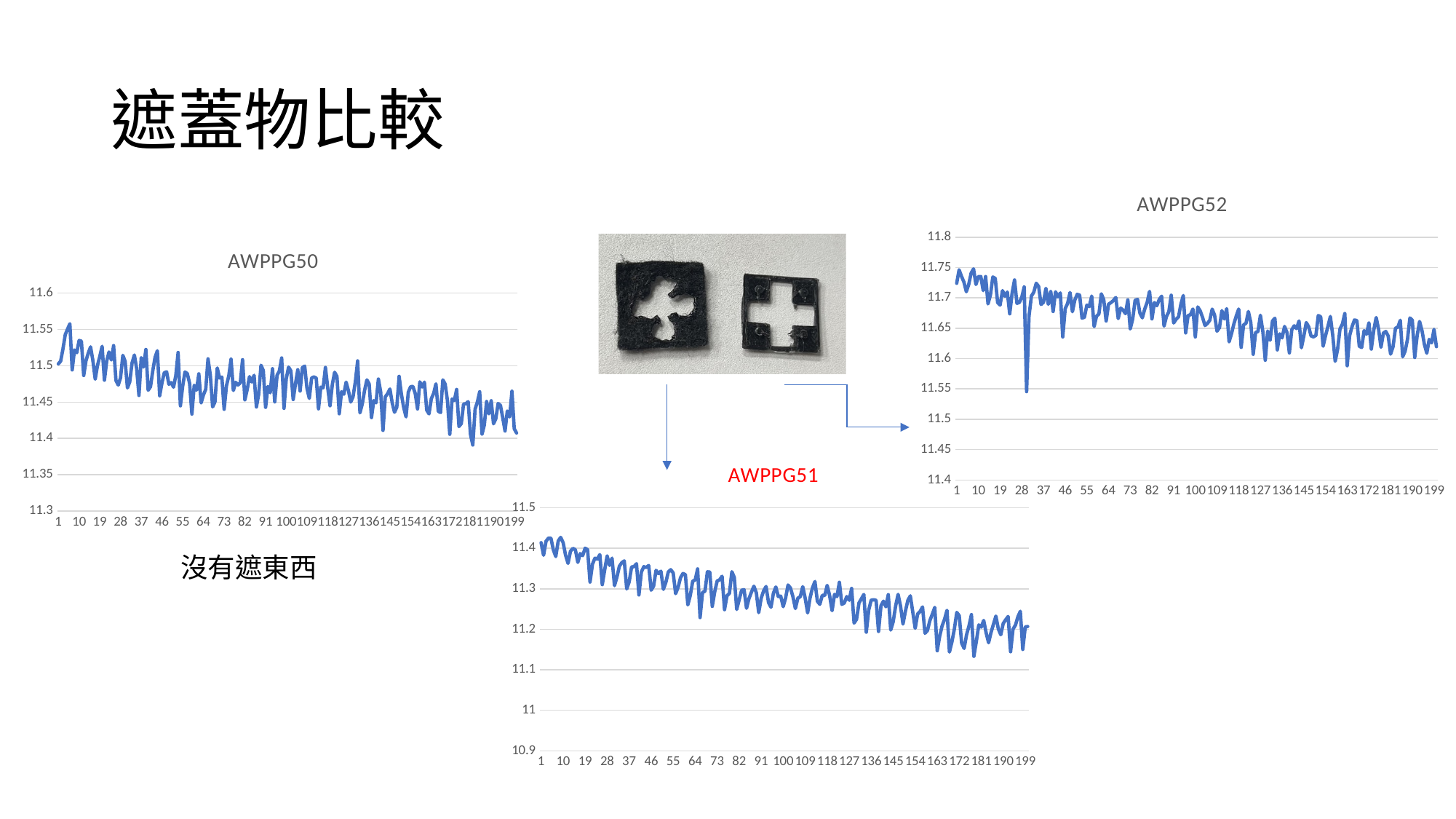
What kind of chart is the AWPPG50 chart? line chart In the AWPPG52 chart, do the values generally rise or fall from left to right? fall In the AWPPG50 chart, do the values generally rise or fall along the x axis? fall What is the highest y-axis tick label on the AWPPG51 chart? 11.5 In the AWPPG51 chart, is the value at x = 199 greater or less than 11.3? less In the AWPPG51 chart, do the values generally rise or fall along the x axis? fall In the AWPPG50 chart, is the value at x = 1 greater or less than 11.45? greater What is the title of the chart on the right side of the slide? AWPPG52 How many charts are shown on the slide? 3 In the AWPPG51 chart, which is larger: the value at x = 1 or the value at x = 199? x = 1 In the AWPPG52 chart, is the lowest point of the line (the sharp dip near x = 28) greater or less than 11.6? less